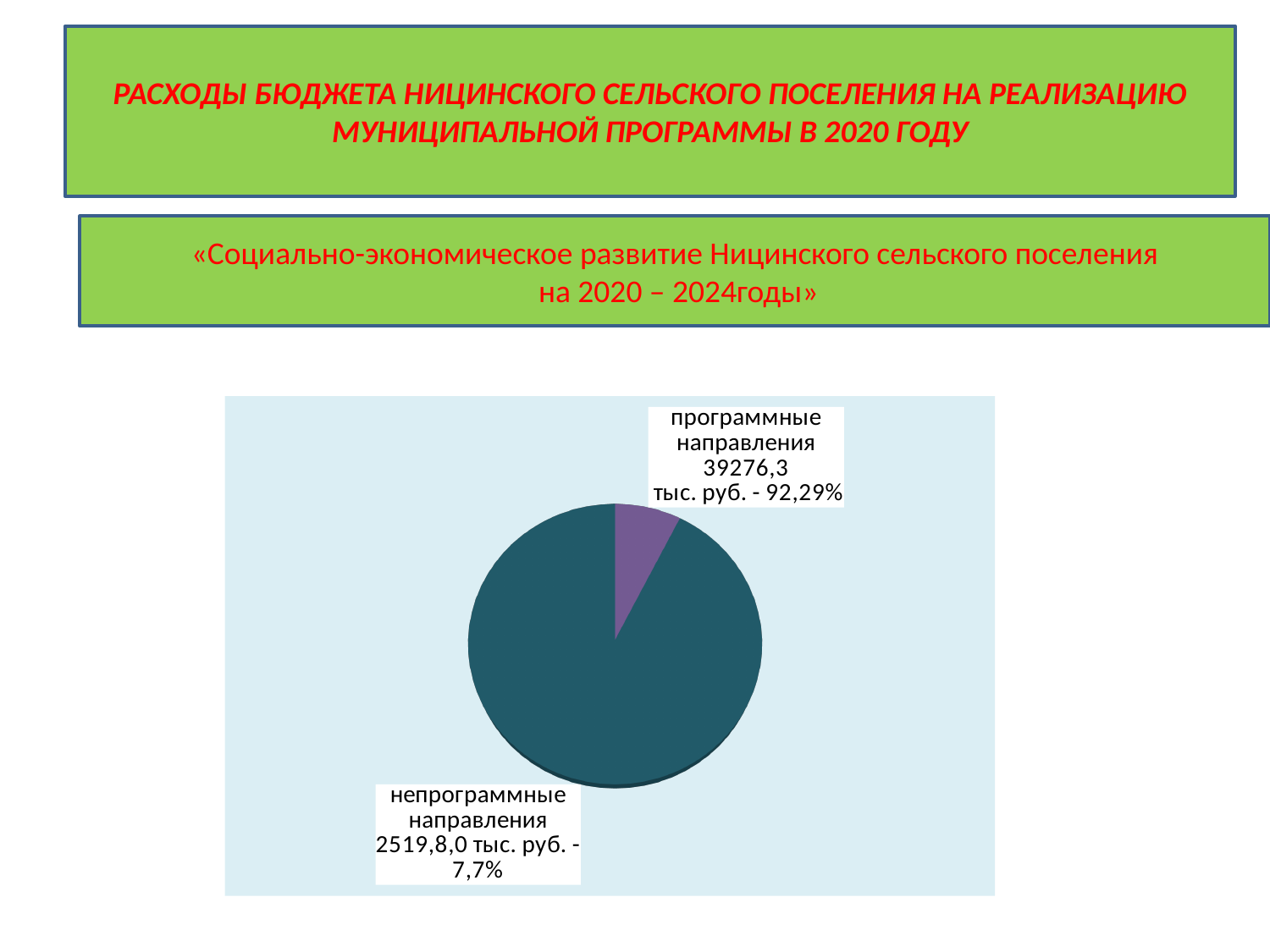
What kind of chart is shown on the slide? pie chart What share of the pie does the slice 'непрограммные направления' represent? 7,7% What value in тыс. руб. is shown for 'программные направления'? 39276,3 тыс. руб. How many slices does the pie chart have? 2 What share of the pie does the slice 'программные направления' represent? 92,29% What value in тыс. руб. is shown for 'непрограммные направления'? 2519,8,0 тыс. руб. Which is larger: the share for 'программные направления' or for 'непрограммные направления'? программные направления Is the share for 'непрограммные направления' greater or less than 10%? less What is the name of the municipal programme shown in the green box above the chart? «Социально-экономическое развитие Ницинского сельского поселения на 2020 – 2024годы»